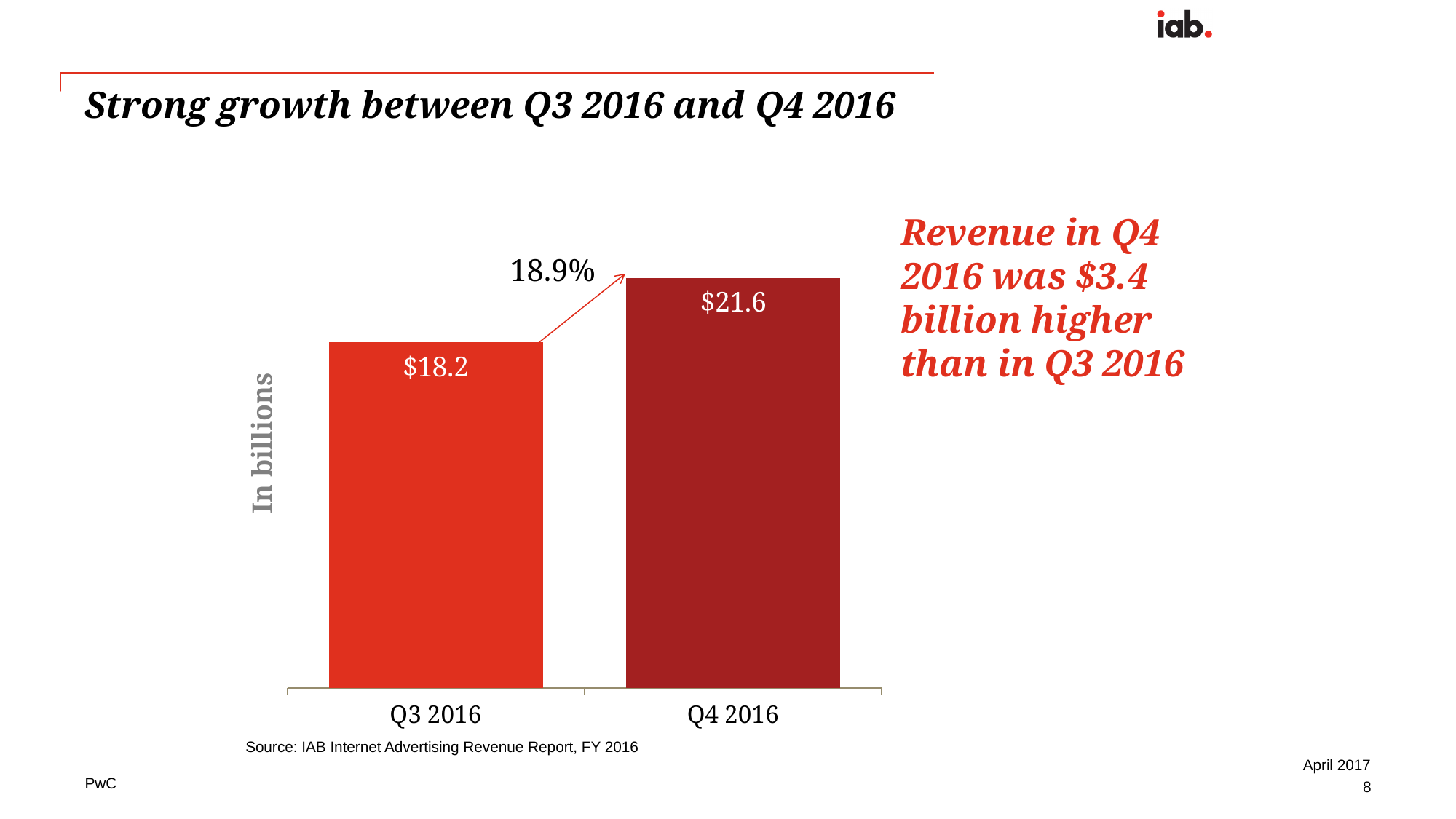
Which quarter has the higher value? Q4 2016 Is the value for Q4 2016 larger or smaller than the value for Q3 2016? larger How many categories are shown on the x axis? 2 Do the values rise or fall from Q3 2016 to Q4 2016? rise What is the label on the vertical axis of the chart? In billions What is the difference between the Q4 2016 and Q3 2016 values? $3.4 What is the value for Q4 2016? $21.6 What is the value for Q3 2016? $18.2 What percentage growth is labelled on the arrow between the two bars? 18.9% What kind of chart is shown on the slide? bar chart Which quarter has the lower value? Q3 2016